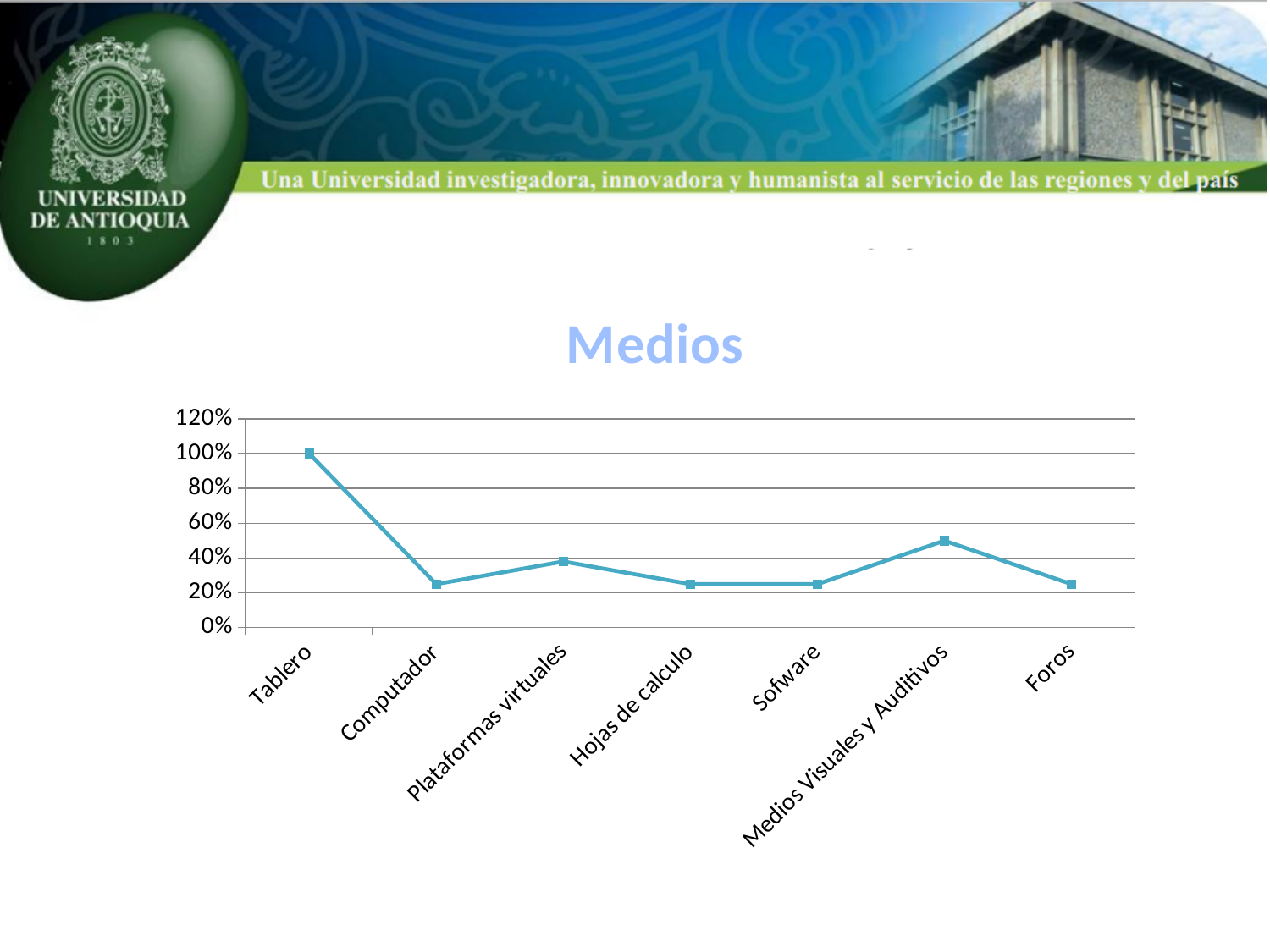
Is the value for Foros greater or less than 40%? less Does the line rise or fall from Tablero to Computador? fall Which is larger, the value for Medios Visuales y Auditivos or the value for Plataformas virtuales? Medios Visuales y Auditivos How many categories are plotted along the x axis of the chart? 7 Is the value for Sofware greater or less than 60%? less Is the value for Medios Visuales y Auditivos greater or less than 40%? greater What is the title of the chart? Medios Which is larger, the value for Plataformas virtuales or the value for Computador? Plataformas virtuales Which category has the highest value? Tablero What type of chart is shown on the slide? line chart What is the value for Tablero? 100%